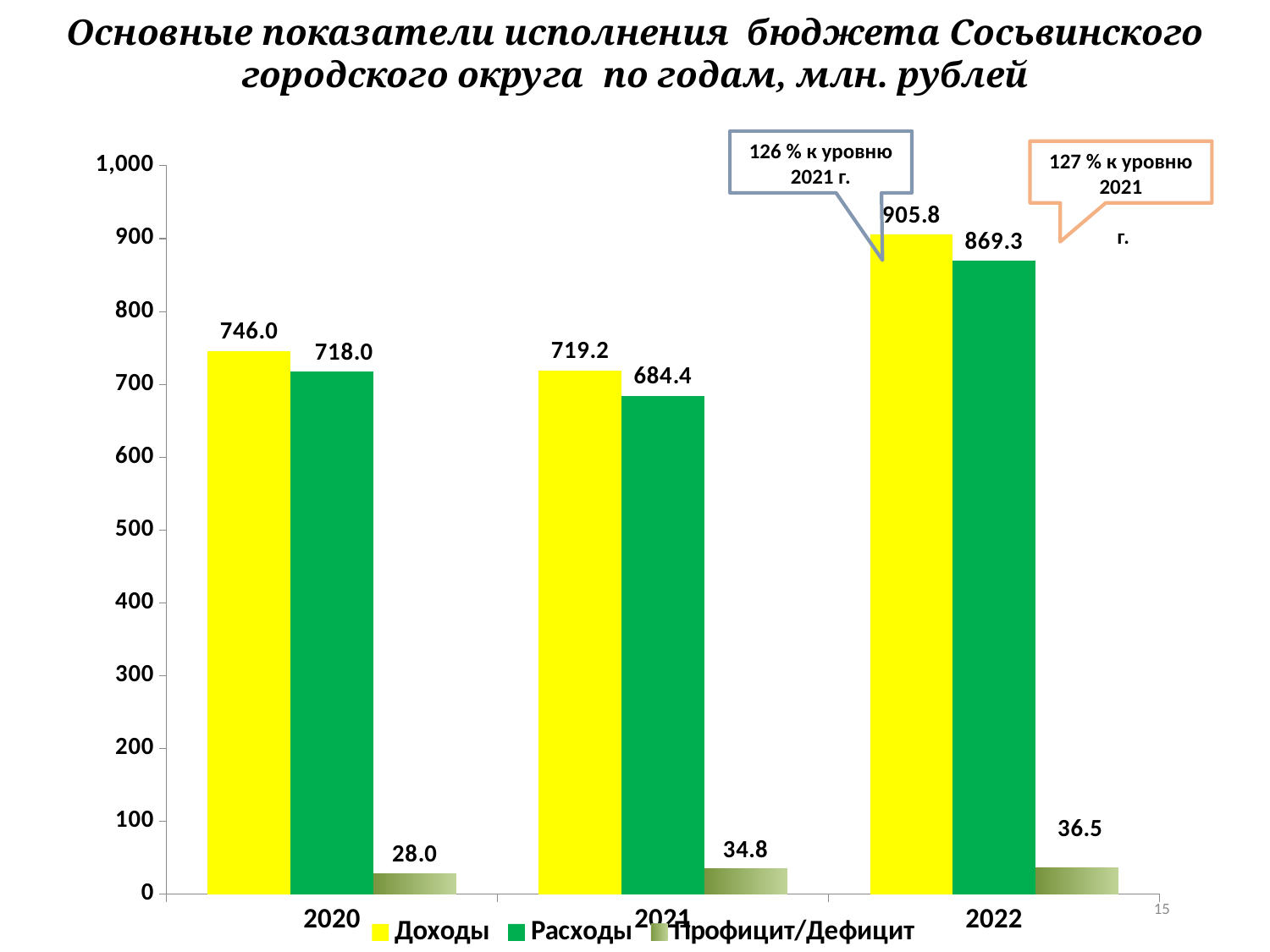
Is the value of Расходы for 2022 greater or less than 800? greater What kind of chart is shown on the slide? Bar chart What is the value of Расходы for 2021? 684.4 Does the value of Профицит/Дефицит rise or fall from 2020 to 2022? Rise What is the difference between Доходы and Расходы in 2022? 36.5 What is the value of Доходы for 2022? 905.8 Which year has the lowest value for Расходы? 2021 How many series does the legend list? 3 What is the value of Профицит/Дефицит for 2020? 28.0 Which year has the highest value for Доходы? 2022 Which is larger in 2020: Доходы or Расходы? Доходы How many years are shown on the x axis? 3